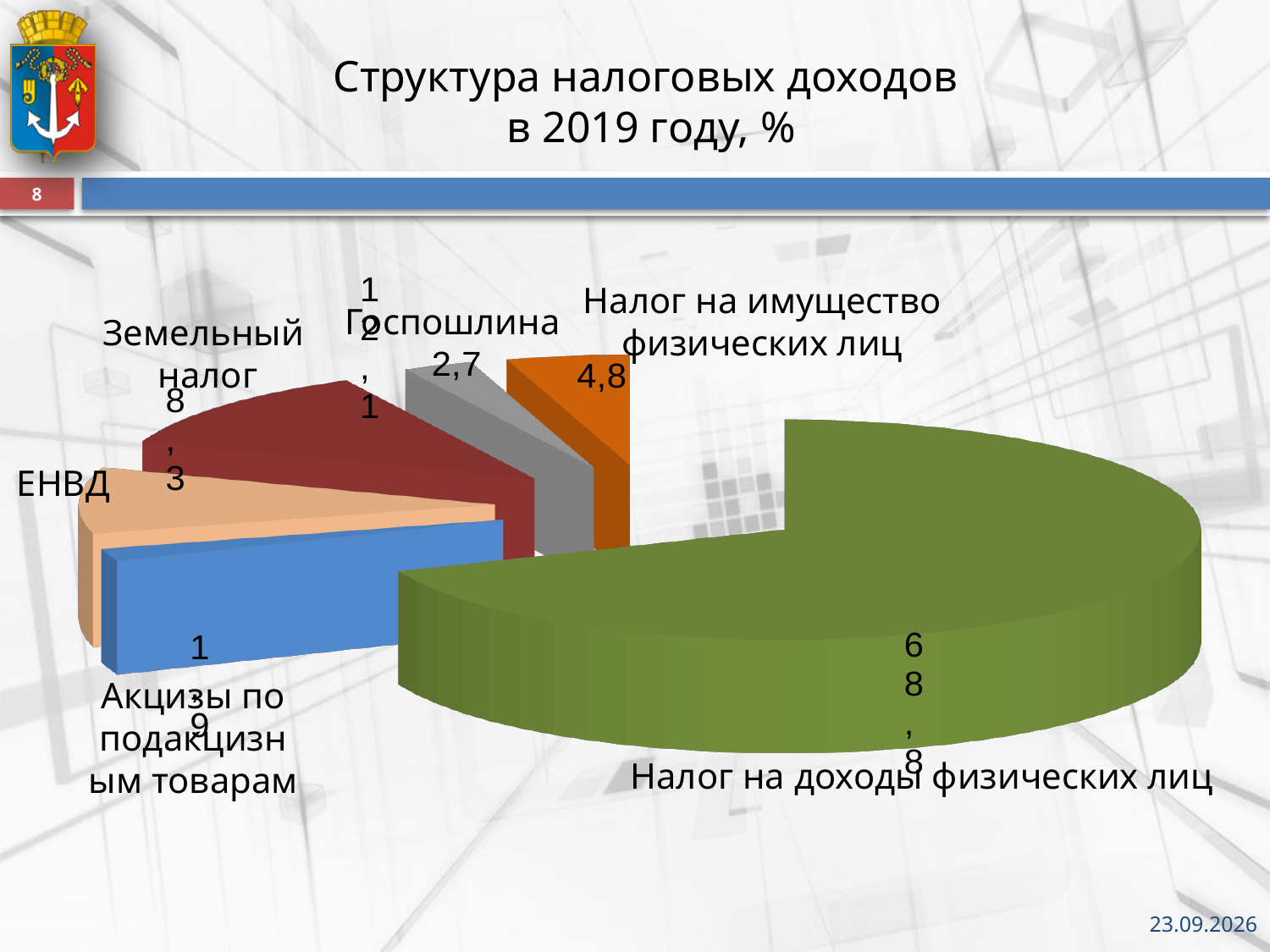
What share of tax revenues does Налог на доходы физических лиц account for? 68,8% How many categories (slices) does the pie chart have? 6 What is the title of the chart? Структура налоговых доходов в 2019 году, % Which is larger: Налог на имущество физических лиц or Госпошлина? Налог на имущество физических лиц What is the value for Налог на имущество физических лиц? 4,8 What kind of chart is shown on the slide? pie chart What is the value for Госпошлина? 2,7 Which category has the largest share of the pie? Налог на доходы физических лиц What colour is the slice for Налог на доходы физических лиц? green What is the difference between the values for Налог на имущество физических лиц and Госпошлина? 2,1 What is the value for Налог на доходы физических лиц? 68,8